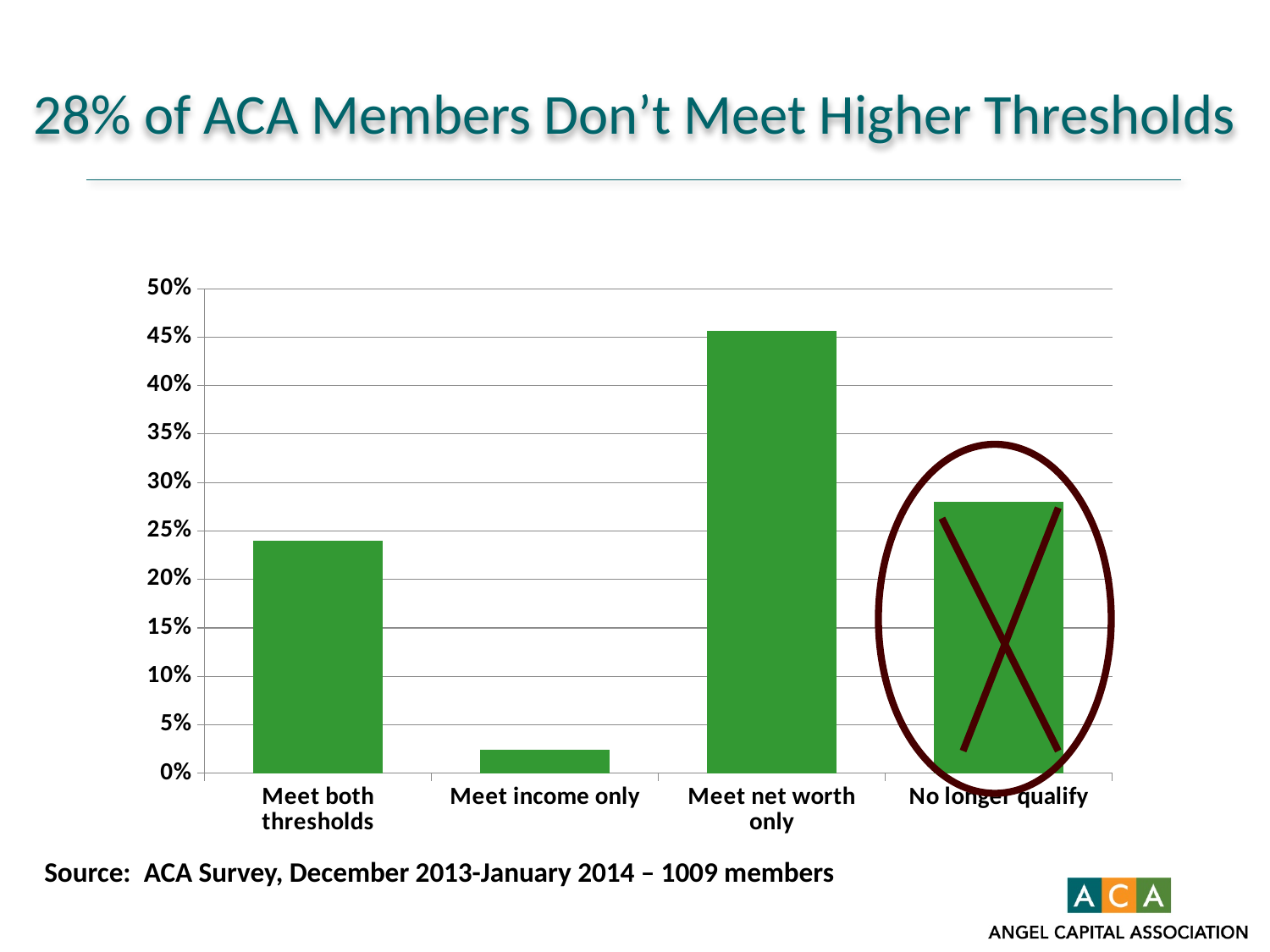
What is the title of the slide containing the chart? 28% of ACA Members Don't Meet Higher Thresholds Is the value for Meet net worth only greater or less than 40%? greater What kind of chart is shown on the slide? bar chart How many categories are shown on the x axis of the chart? 4 Is the value for Meet income only greater or less than 5%? less Which bar in the chart is circled and crossed out? No longer qualify Is the value for No longer qualify greater or less than 30%? less Which is larger, the value for No longer qualify or the value for Meet both thresholds? No longer qualify Which category has the lowest value in the chart? Meet income only Which category has the highest value in the chart? Meet net worth only Which is larger, the value for Meet net worth only or the value for Meet both thresholds? Meet net worth only